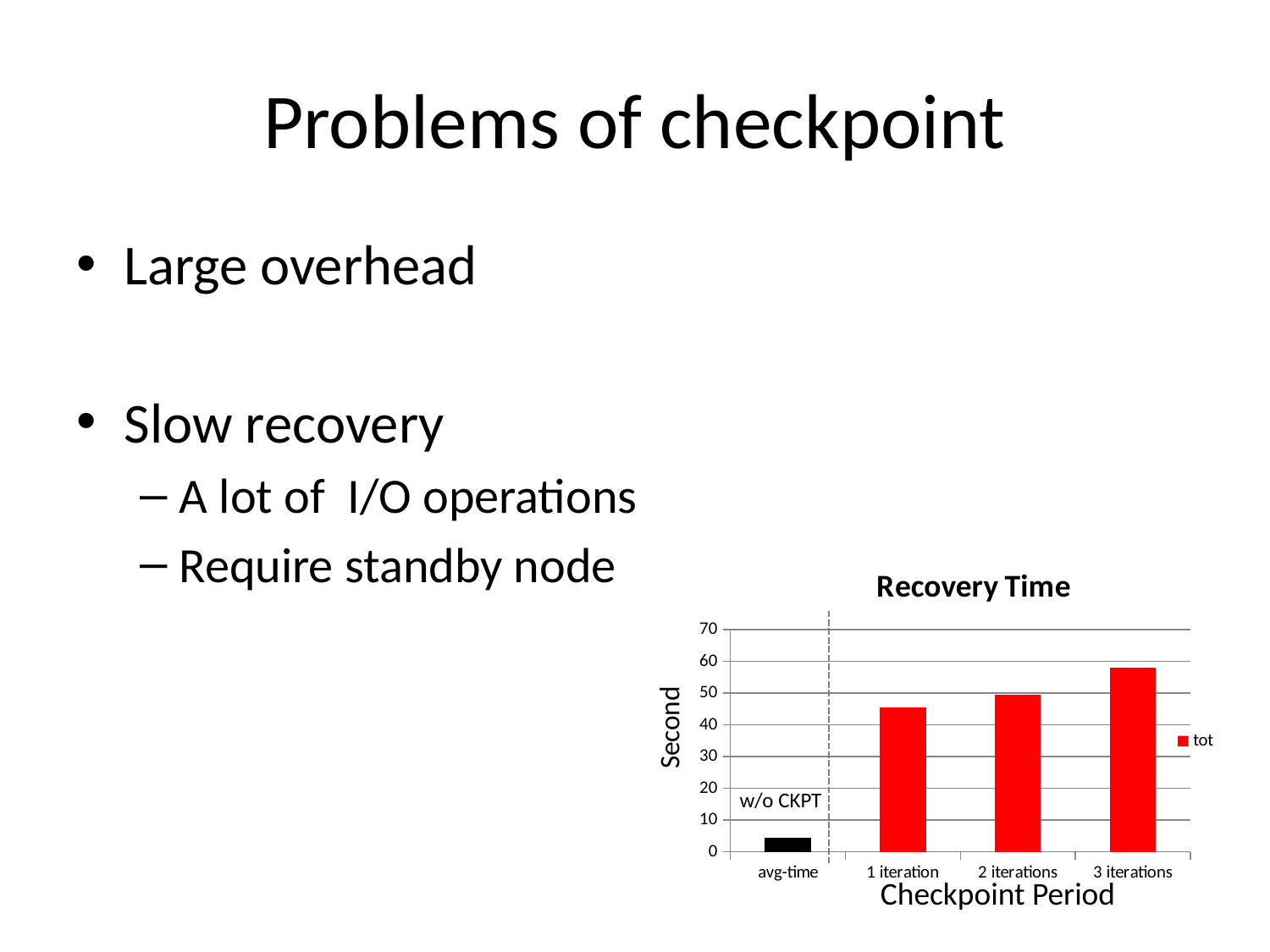
What is the title of the chart? Recovery Time How many series does the chart's legend list? 1 Is the value for 3 iterations greater or less than 50? greater Which category has the lowest value in the chart? avg-time What is the label of the y axis of the chart? Second How many categories are shown on the x axis of the chart? 4 Is the value for avg-time greater or less than 10? less Which is larger, the value for 1 iteration or the value for 3 iterations? 3 iterations Is the value for 1 iteration greater or less than 50? less Do the values rise or fall from 1 iteration to 3 iterations along the x axis? rise What kind of chart is shown on the slide? bar chart Which category has the highest recovery time in the chart? 3 iterations